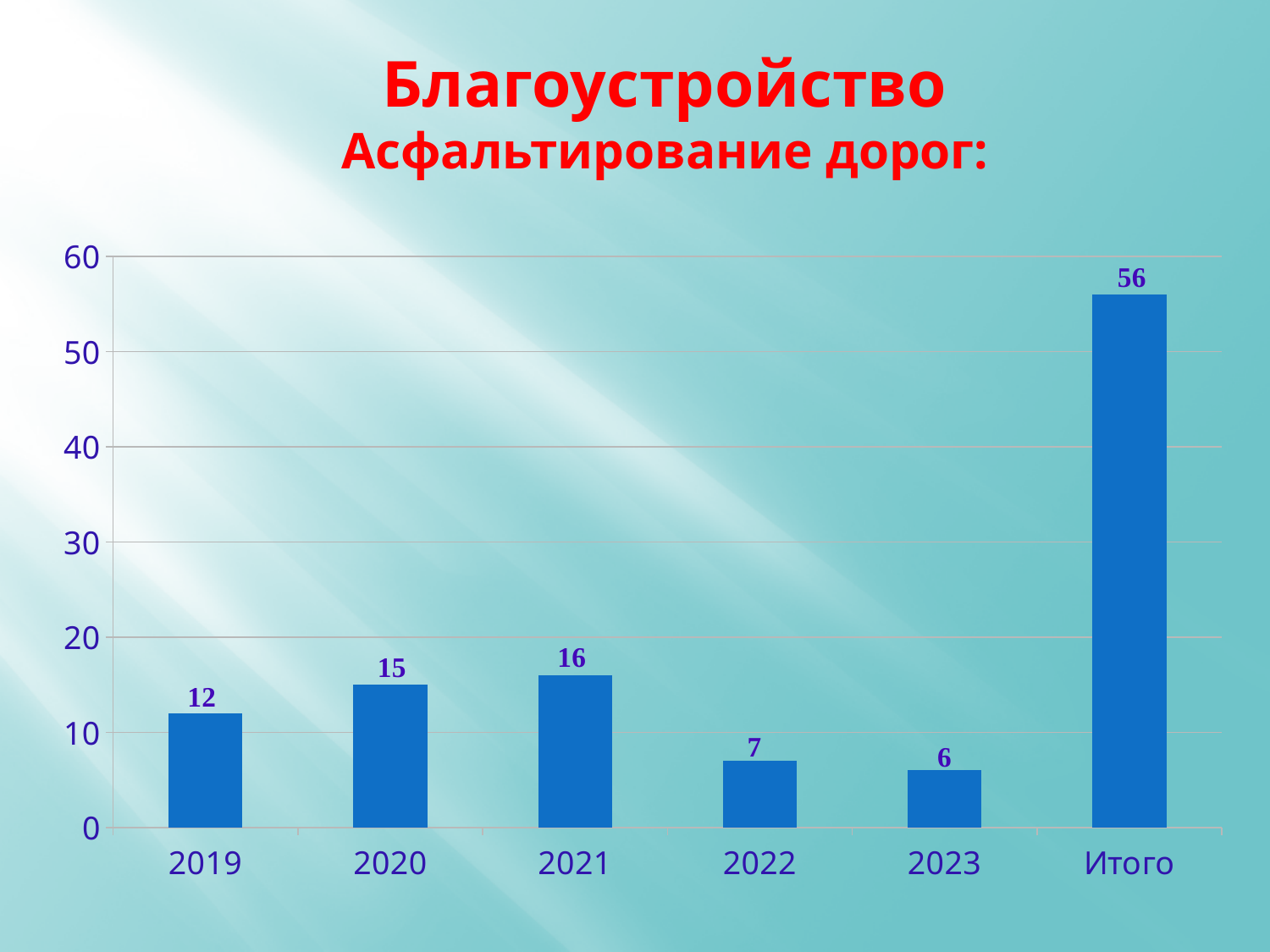
Which year from 2019 to 2023 has the highest value? 2021 What is the value for 2019? 12 What is the value for 2021? 16 Is the value for Итого greater or less than 50? greater Which is larger, the value for 2020 or the value for 2022? 2020 What is the value for Итого? 56 What is the value for 2023? 6 Which category has the lowest value? 2023 How many categories are shown on the x axis? 6 Do the values rise or fall from 2021 to 2023? fall What is the difference between the values for 2021 and 2022? 9 What kind of chart is shown on the slide? bar chart